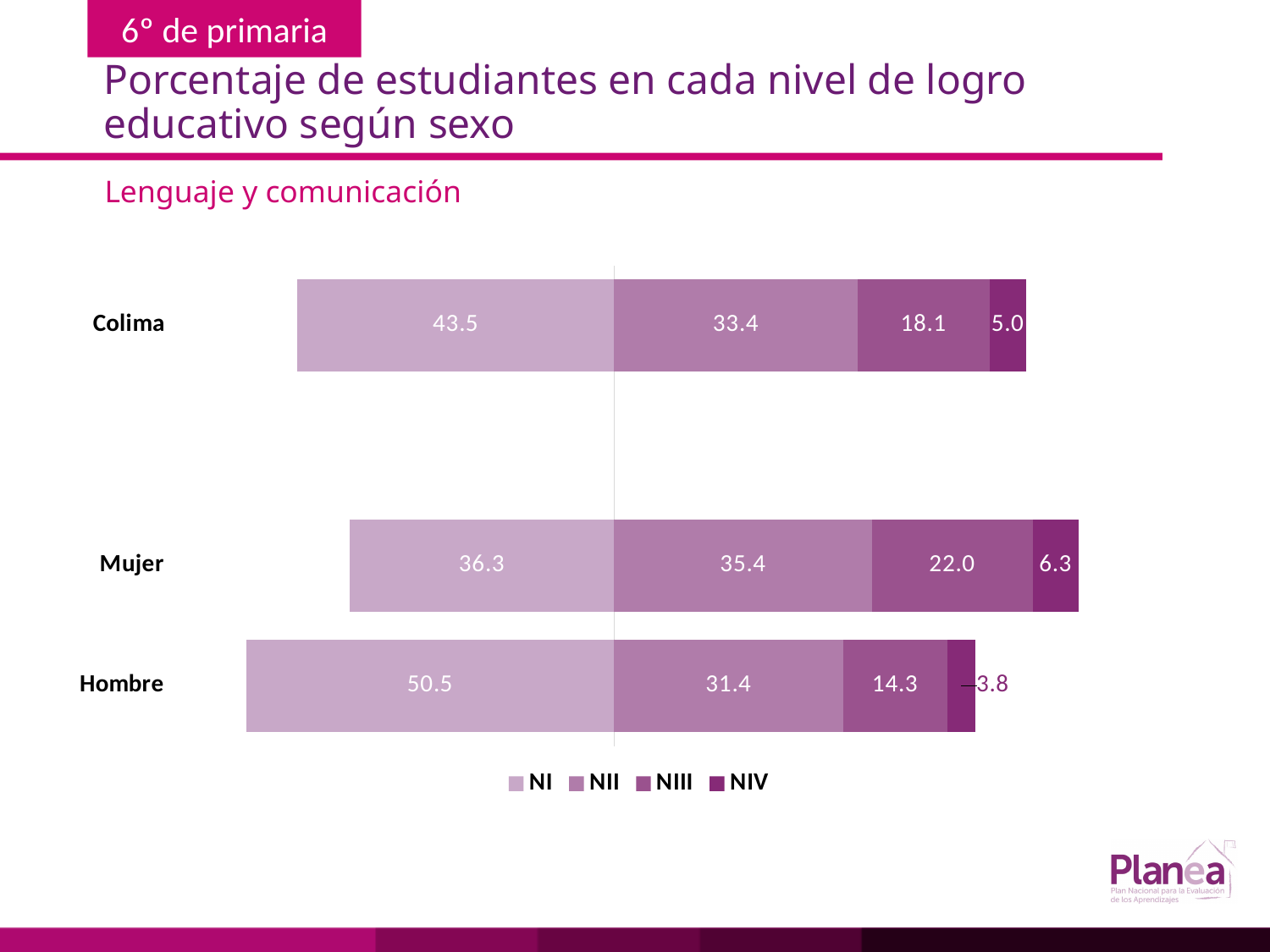
Which category has the highest NI value? Hombre How many categories are shown on the chart? 3 What is the NIV value for Colima? 5.0 What is the total of the stacked bar for Mujer? 100.0 What subject is named in the subtitle above the chart? Lenguaje y comunicación How many series does the legend list? 4 What is the difference between the NI values for Hombre and Mujer? 14.2 What kind of chart is shown on the slide? Stacked bar chart What is the NI value for Hombre? 50.5 Which category has the lowest NIV value? Hombre What is the NIII value for Mujer? 22.0 Which is larger, the NII value for Mujer or the NII value for Colima? Mujer